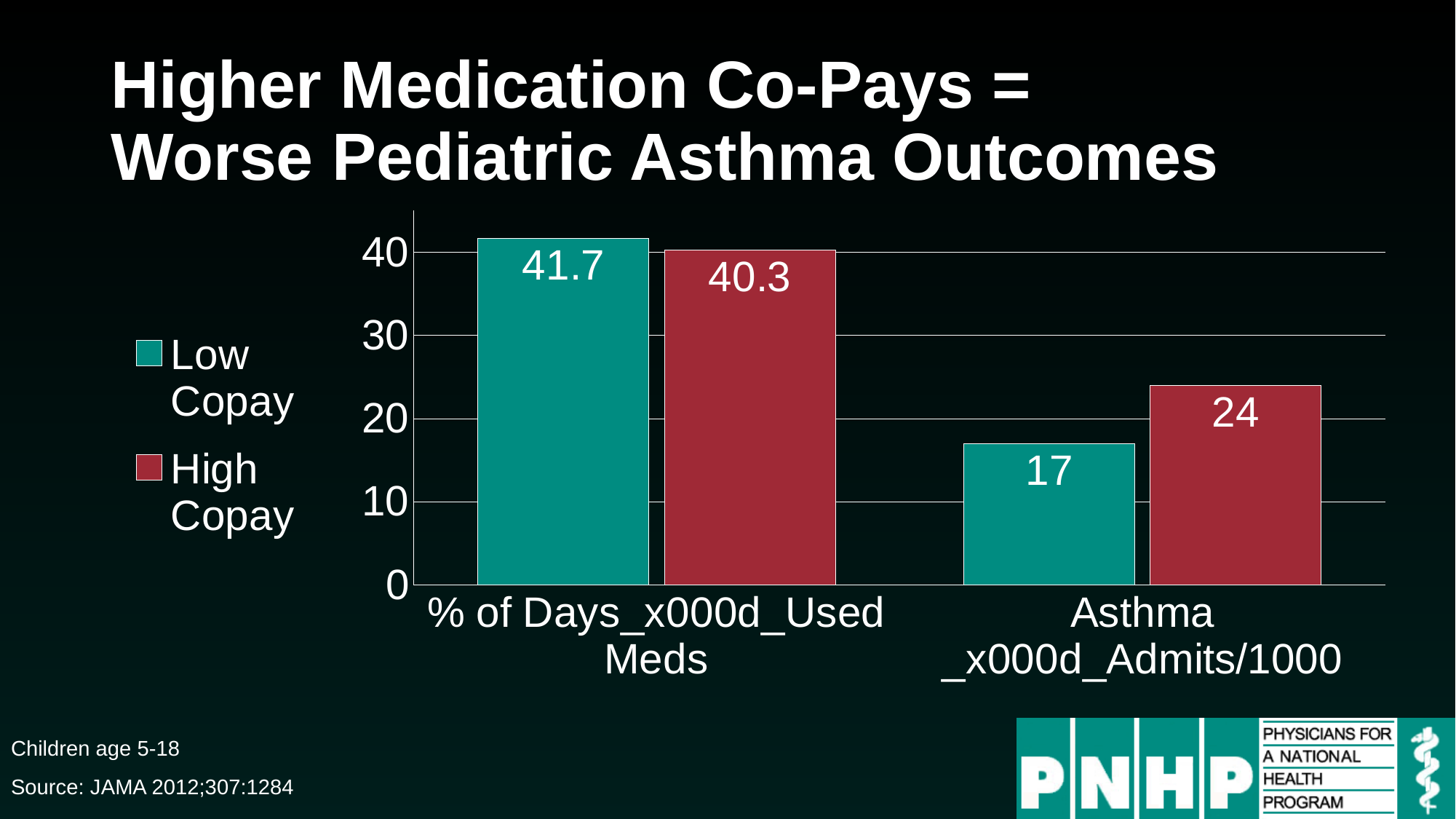
How many series does the legend list? 2 Which copay group has the higher value for Asthma Admits/1000? High Copay What is the difference between the Low Copay and High Copay values for % of Days Used Meds? 1.4 How many categories are shown on the x axis? 2 What is the High Copay value for % of Days Used Meds? 40.3 What is the difference between the High Copay and Low Copay values for Asthma Admits/1000? 7 What is the Low Copay value for % of Days Used Meds? 41.7 What kind of chart is shown on the slide? Bar chart What is the Low Copay value for Asthma Admits/1000? 17 What is the High Copay value for Asthma Admits/1000? 24 Which colour represents the High Copay series? Red Which copay group has the higher value for % of Days Used Meds? Low Copay